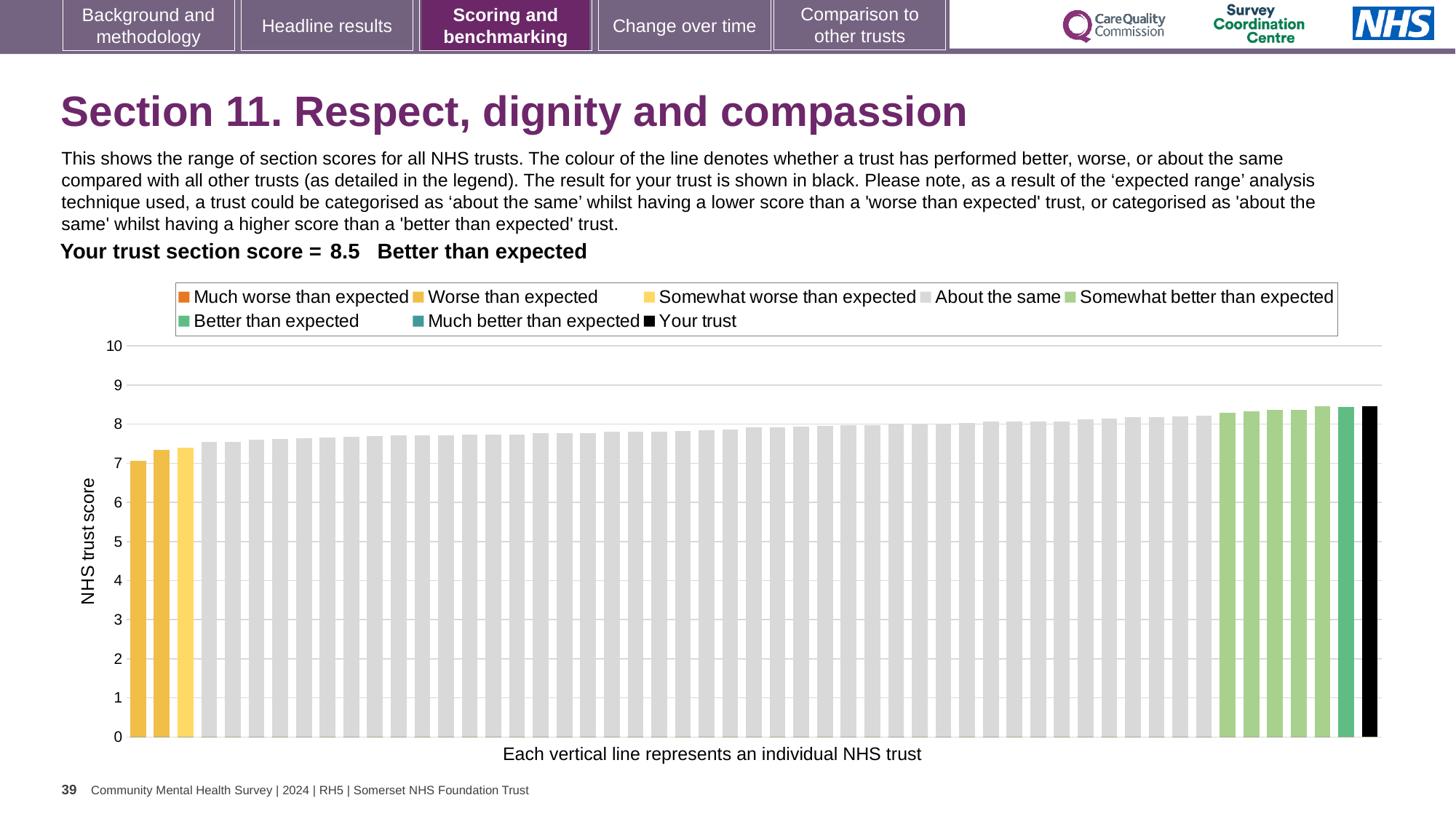
Which category does your trust's section score fall into according to the slide? Better than expected What is the section score for your trust shown on the slide? 8.5 Is the value of the highest bar greater or less than 9? less What is the maximum value shown on the vertical axis? 10 What type of chart is shown on the slide? bar chart What colour is the bar representing your trust? black What is the label on the vertical axis of the chart? NHS trust score Is the value of the 'Your trust' bar greater or less than 8? greater How many entries does the chart legend list? 8 How many bars are coloured as 'Somewhat better than expected' (light green)? 5 Is the value of the leftmost bar greater or less than 8? less Do the bar values rise or fall from left to right across the chart? rise